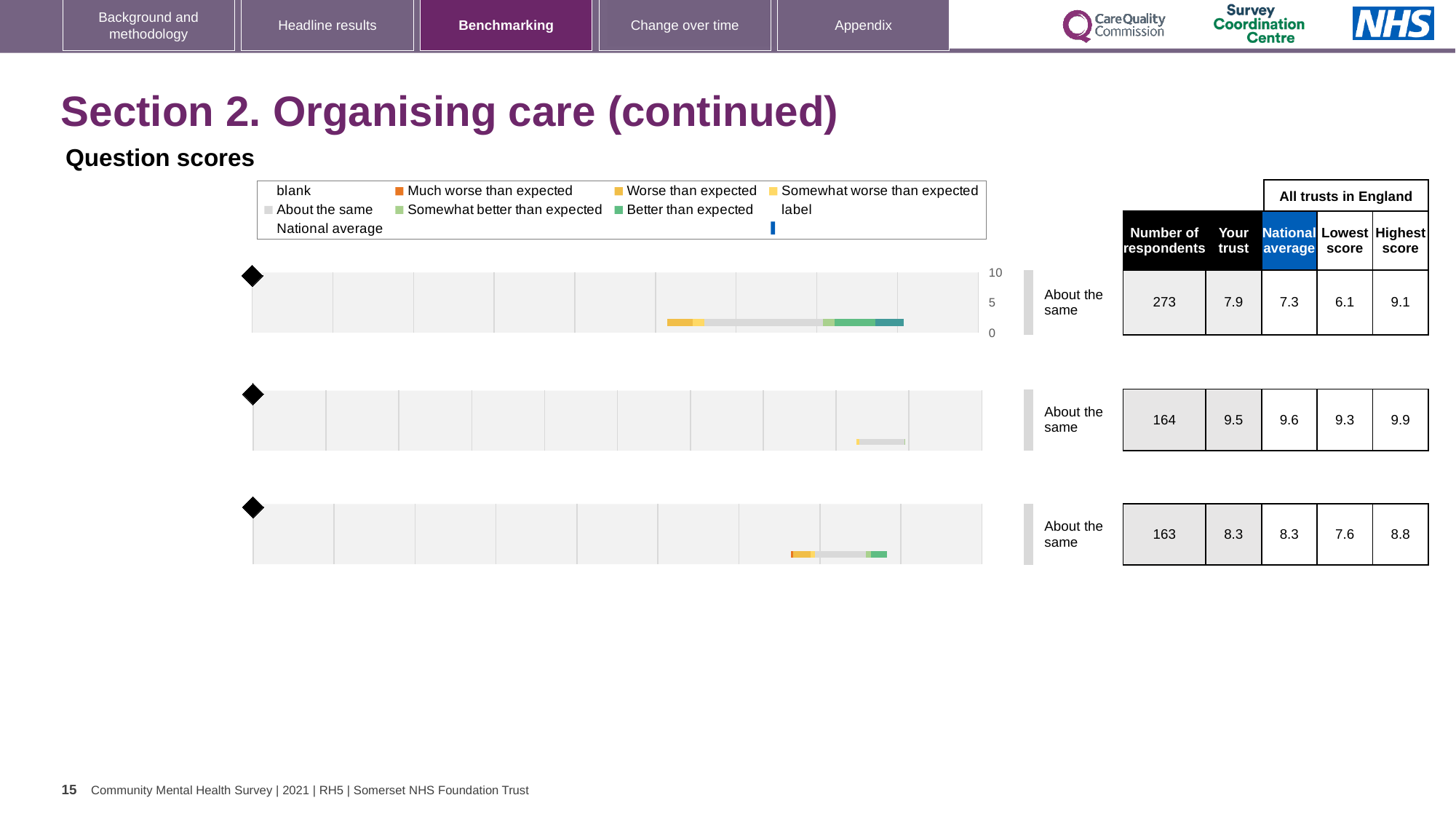
Which chart (top, middle or bottom) has the highest 'Your trust' score? middle For the middle chart, how many respondents are listed? 164 What is the maximum value shown on the score axis of the top chart? 10 What benchmark category is shown next to the bottom chart? About the same For the bottom chart, what is the highest score among all trusts in England? 8.8 What kind of chart is used to show the question scores on this slide? bar chart For the top chart, what is the difference between the highest score and the lowest score? 3.0 For the middle chart, which is larger: the 'Your trust' score or the national average? National average For the top chart, what is the 'Your trust' score shown in the table? 7.9 For the top chart, which is larger: the 'Your trust' score or the national average? Your trust How many question score charts are shown on the slide? 3 For the top chart, what is the national average score? 7.3